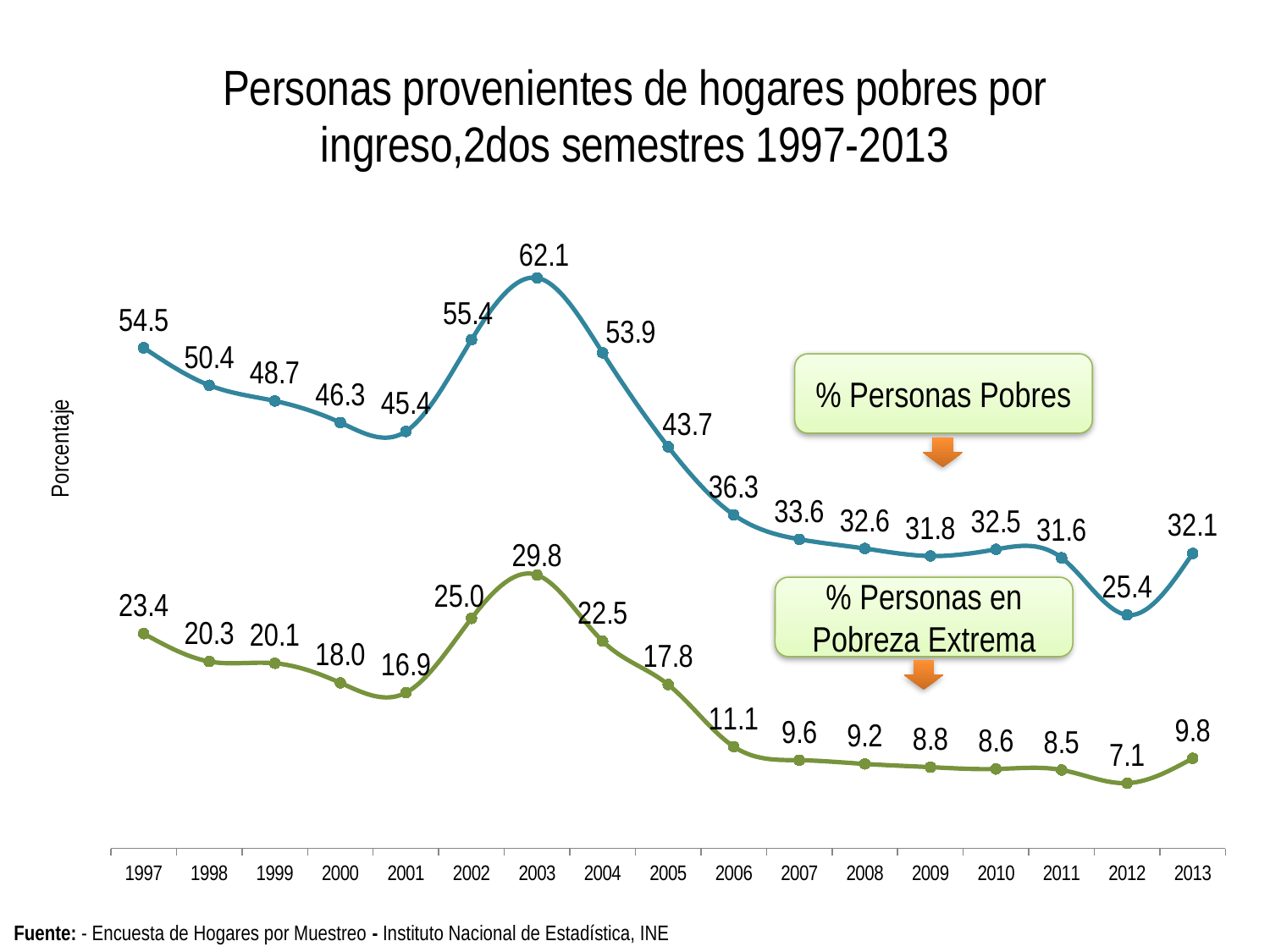
How many years are shown on the x axis? 17 Which is larger: % Personas Pobres in 2002 or in 2004? 2002 What is the label of the y axis? Porcentaje What is the difference between % Personas Pobres and % Personas en Pobreza Extrema in 2013? 22.3 What is the value for % Personas Pobres in 2003? 62.1 Does % Personas Pobres rise or fall from 2003 to 2009? fall What kind of chart is shown on the slide? line chart How many series are plotted on the chart? 2 In which year is % Personas Pobres highest? 2003 What is the value for % Personas en Pobreza Extrema in 2012? 7.1 In which year is % Personas en Pobreza Extrema lowest? 2012 What is the value for % Personas Pobres in 1997? 54.5